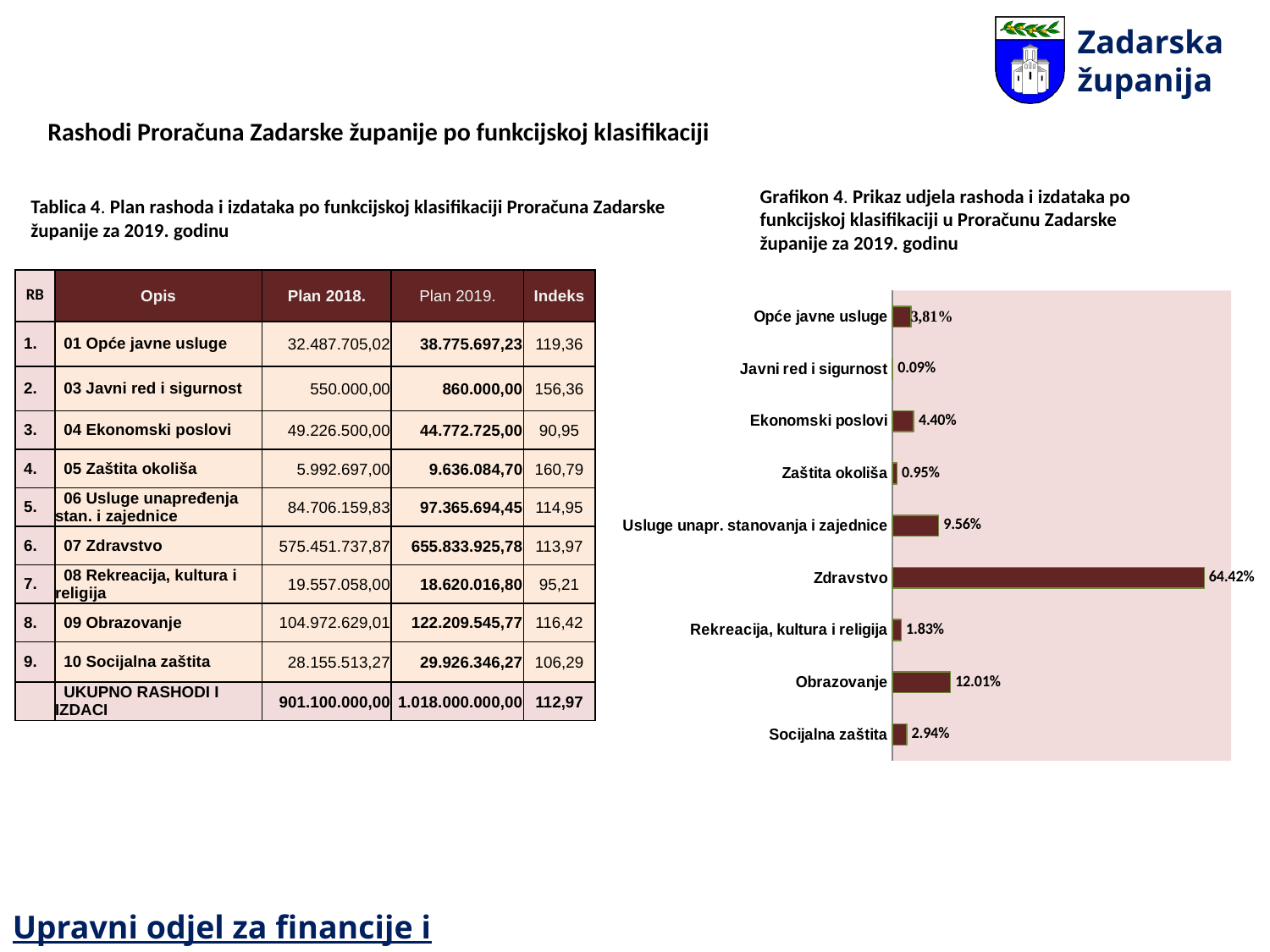
What is the value shown for Usluge unapr. stanovanja i zajednice in the chart? 9.56% What is the value shown for Socijalna zaštita in the chart? 2.94% What is the value shown for Obrazovanje in the chart? 12.01% What is the value shown for Javni red i sigurnost in the chart? 0.09% Which is larger, the value for Ekonomski poslovi or the value for Socijalna zaštita? Ekonomski poslovi What is the difference between the values for Zdravstvo and Obrazovanje? 52.41% What is the value shown for Zdravstvo in the chart? 64.42% Which category has the lowest value in the chart? Javni red i sigurnost How many categories are shown in the chart? 9 What is the title of the chart? Grafikon 4. Prikaz udjela rashoda i izdataka po funkcijskoj klasifikaciji u Proračunu Zadarske županije za 2019. godinu Which category has the highest value in the chart? Zdravstvo What kind of chart is shown on the slide? Bar chart